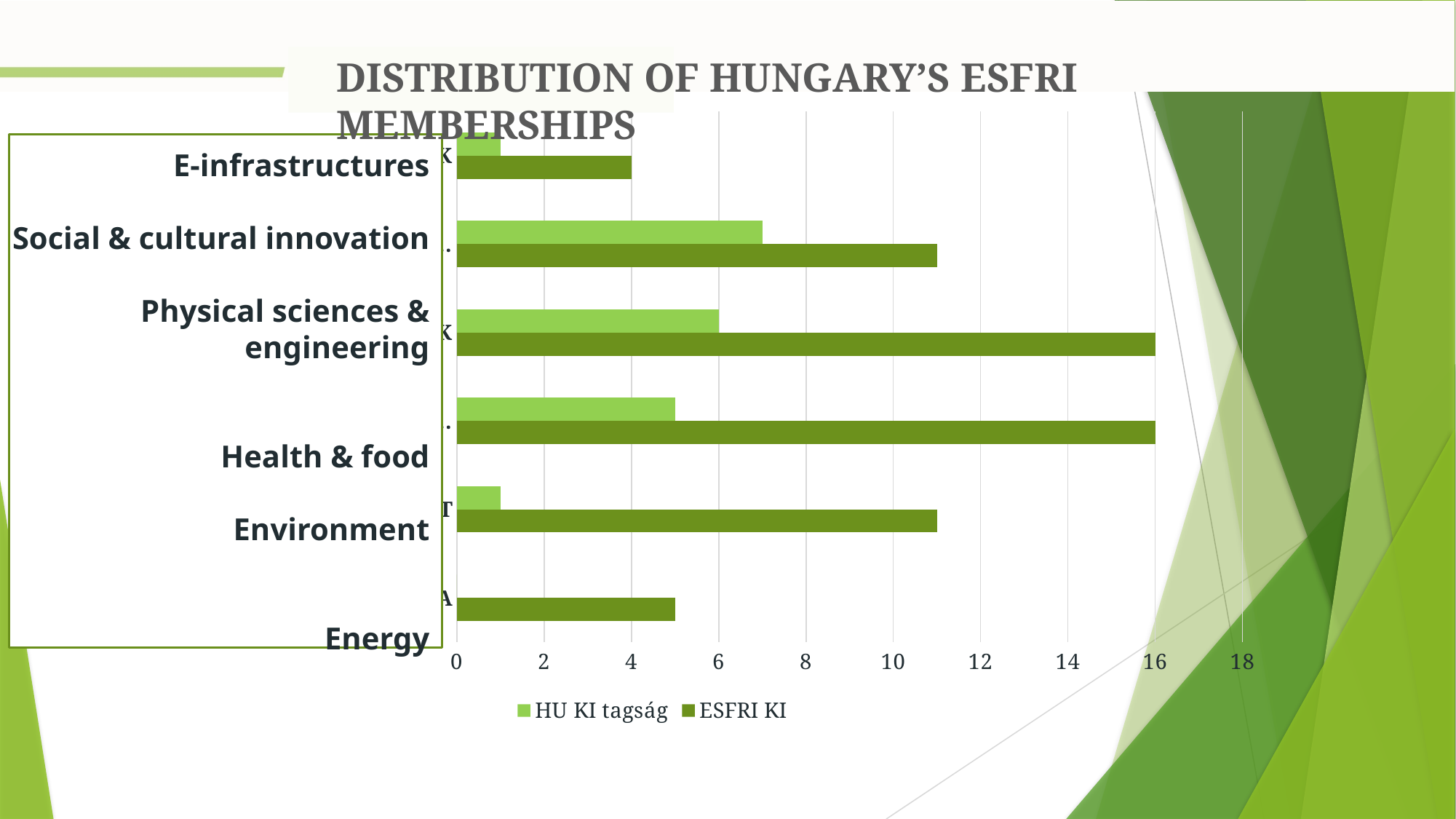
How many series does the legend list? 2 What is the difference between the ESFRI KI values for Physical sciences & engineering and E-infrastructures? 12 What is the HU KI tagság value for Physical sciences & engineering? 6 What is the ESFRI KI value for Physical sciences & engineering? 16 What is the ESFRI KI value for E-infrastructures? 4 Is the HU KI tagság value for Social & cultural innovation greater or less than 6? greater What type of chart is shown on the slide? Bar chart Which series has the larger value for Physical sciences & engineering, HU KI tagság or ESFRI KI? ESFRI KI Is the HU KI tagság value for E-infrastructures greater or less than 2? less How many categories are shown on the chart? 6